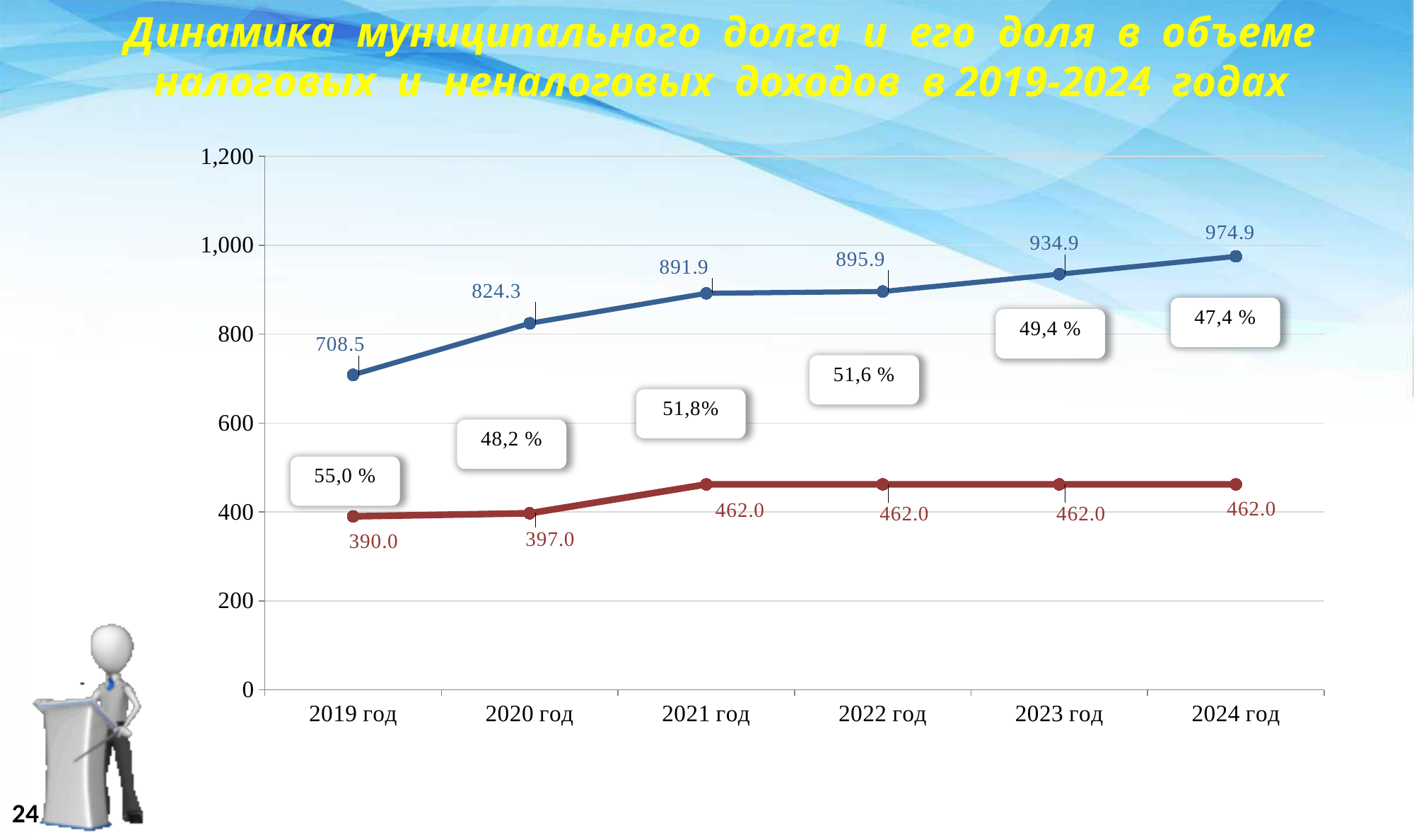
What is the value of the blue line for 2019 год? 708.5 In which year does the blue line reach its highest value? 2024 год What type of chart is shown on the slide? line chart Does the blue line rise or fall from 2019 год to 2024 год? rises What is the value of the red line for 2020 год? 397.0 What is the difference between the red line values for 2021 год and 2020 год? 65.0 What is the difference between the blue line values for 2024 год and 2019 год? 266.4 What percentage is shown in the box for 2021 год? 51,8% In which year does the red line have its lowest value? 2019 год What is the value of the blue line for 2024 год? 974.9 Which is larger for 2022 год: the blue line value or the red line value? the blue line value (895.9) How many years are shown on the x axis? 6